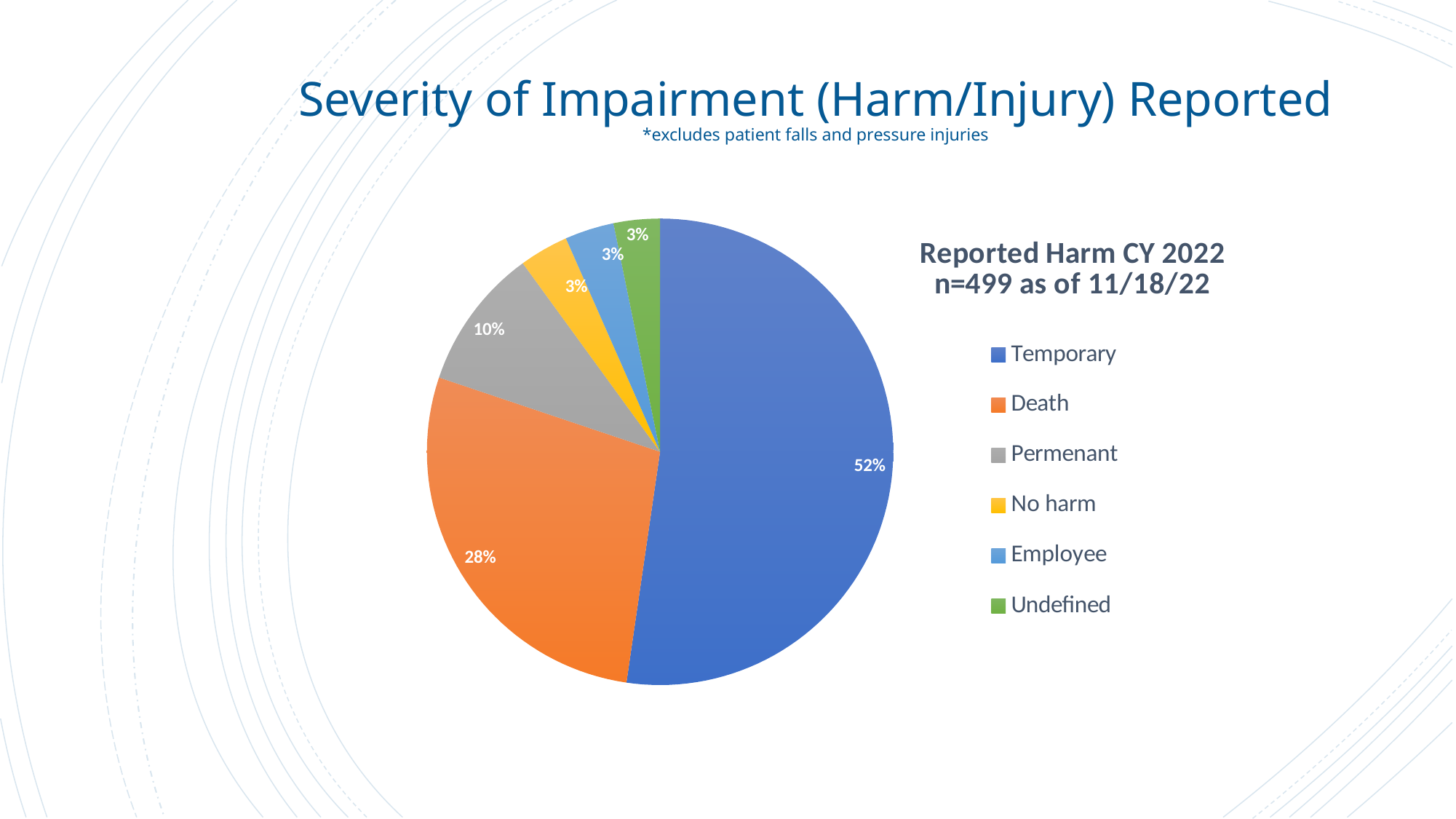
What percentage of reported harm is No harm? 3% What kind of chart is shown on the slide? Pie chart What is the sample size (n) stated next to the chart? 499 What colour is the Death slice? Orange What is the difference in percentage points between Death and Permenant? 18 What percentage of reported harm is Death? 28% Which is larger, the share for Death or the share for Permenant? Death What percentage of reported harm is Permenant? 10% What is the difference in percentage points between Temporary and Death? 24 How many categories does the legend list? 6 What percentage of reported harm is Temporary? 52% Which category has the largest share of the pie? Temporary